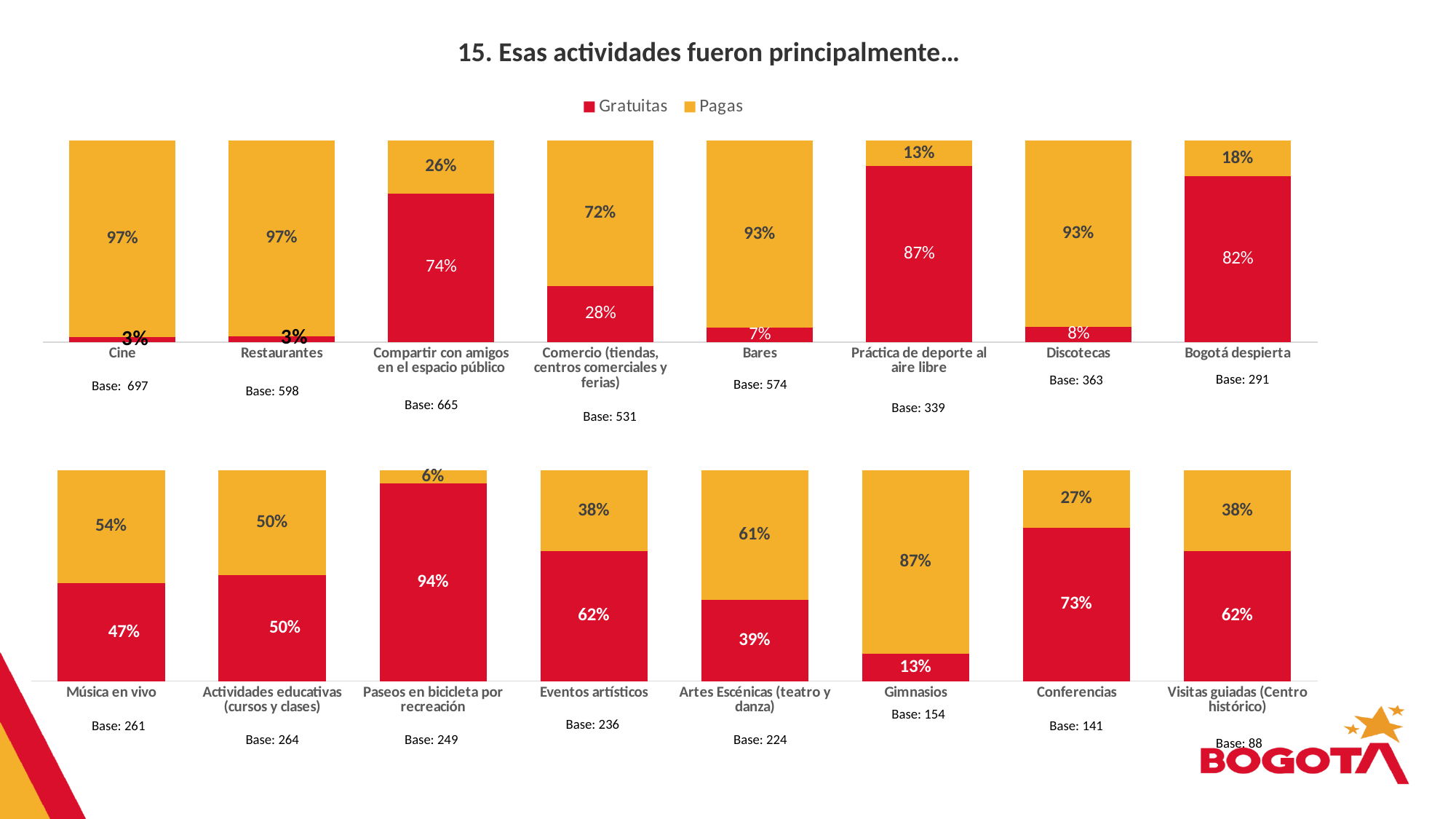
In the bottom chart, what is the Gratuitas value for Conferencias? 73% In the bottom chart, what is the Pagas value for Gimnasios? 87% In the bottom chart, which category has the lowest Pagas value? Paseos en bicicleta por recreación In the bottom chart, what is the total of the stacked bar for Música en vivo? 101% In the top chart, what is the Gratuitas value for Práctica de deporte al aire libre? 87% What kind of chart is the top chart? Stacked bar chart In the top chart, which category has the highest Gratuitas value? Práctica de deporte al aire libre How many series does the legend list? 2 In the top chart, what is the difference between the Pagas values for Bares and Bogotá despierta? 75% In the top chart, what is the Pagas value for Comercio (tiendas, centros comerciales y ferias)? 72% How many categories are shown in the bottom chart? 8 In the bottom chart, which is larger: the Gratuitas value for Eventos artísticos or for Artes Escénicas (teatro y danza)? Eventos artísticos